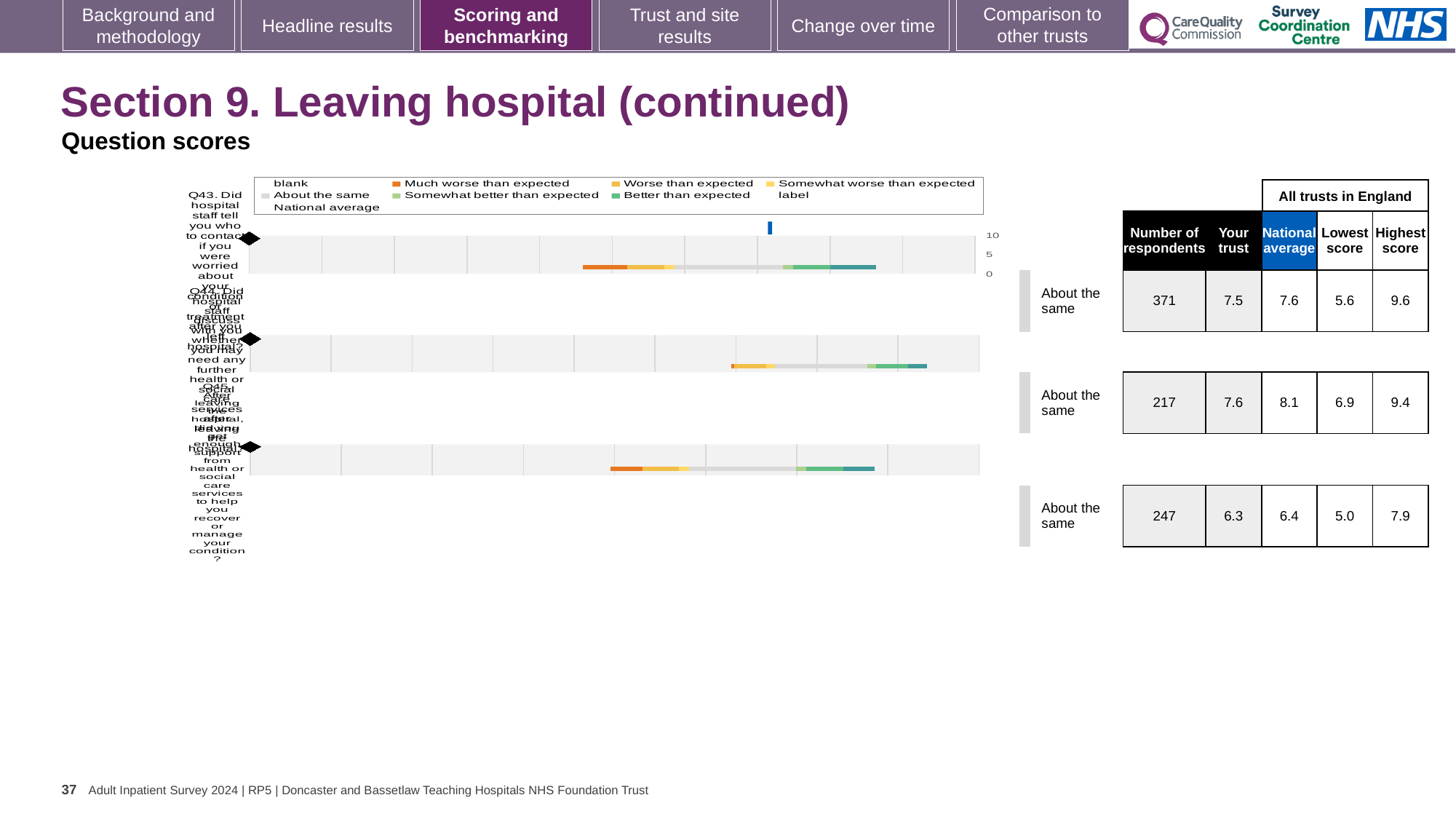
For the bottom chart (Q45), what is the lowest score among all trusts in England? 5.0 Which of the three question charts has the lowest 'Your trust' score? The bottom chart (Q45), 6.3 For the bottom chart (Q45), what is the difference between the national average and the 'Your trust' score? 0.1 For the top chart (Q43), what is the difference between the highest score and the lowest score among all trusts in England? 4.0 What kind of chart is used to show the question scores on this slide? Bar chart For the bottom chart (Q45), what is the highest score among all trusts in England? 7.9 In the top chart (Q43), what is the 'Your trust' score shown in the table? 7.5 In the top chart (Q43), how many respondents are listed in the table? 371 How many question charts are shown on the slide? 3 What benchmark category is shown next to each of the three question charts? About the same For the middle chart (Q44), which is larger: the 'Your trust' score or the national average? National average For the middle chart (Q44), what is the national average score shown in the table? 8.1